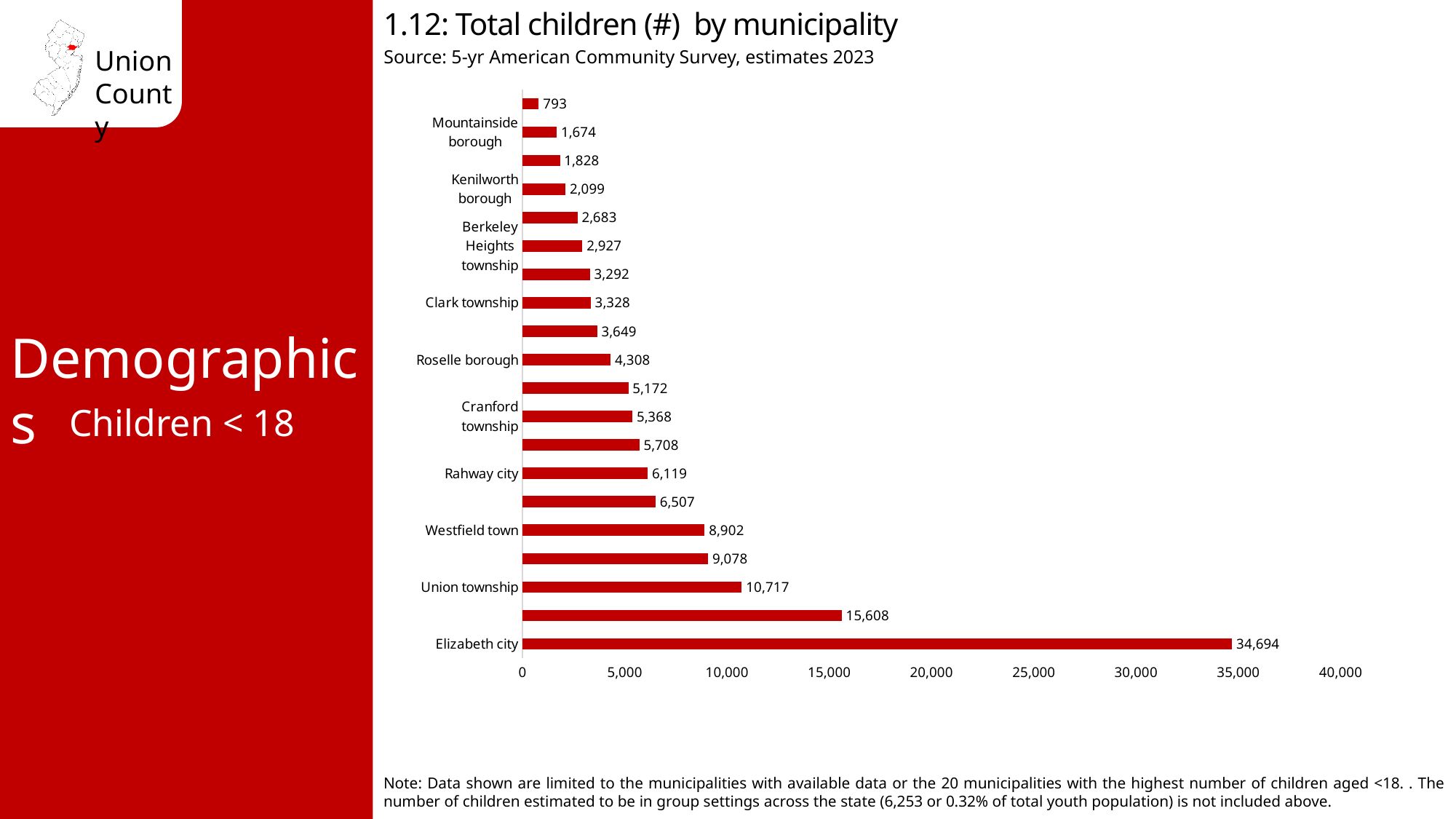
Which municipality has the highest number of children? Elizabeth city What is the value for Elizabeth city? 34,694 How many bars are shown in the chart? 20 What is the difference between the values for Elizabeth city and Union township? 23,977 Which is larger, the value for Cranford township or the value for Roselle borough? Cranford township What kind of chart is shown on the slide? bar chart What is the value for Union township? 10,717 What is the value for Clark township? 3,328 What is the value for Westfield town? 8,902 What is the value for Mountainside borough? 1,674 What is the difference between the values for Westfield town and Rahway city? 2,783 Is the value for Union township greater or less than 10,000? greater